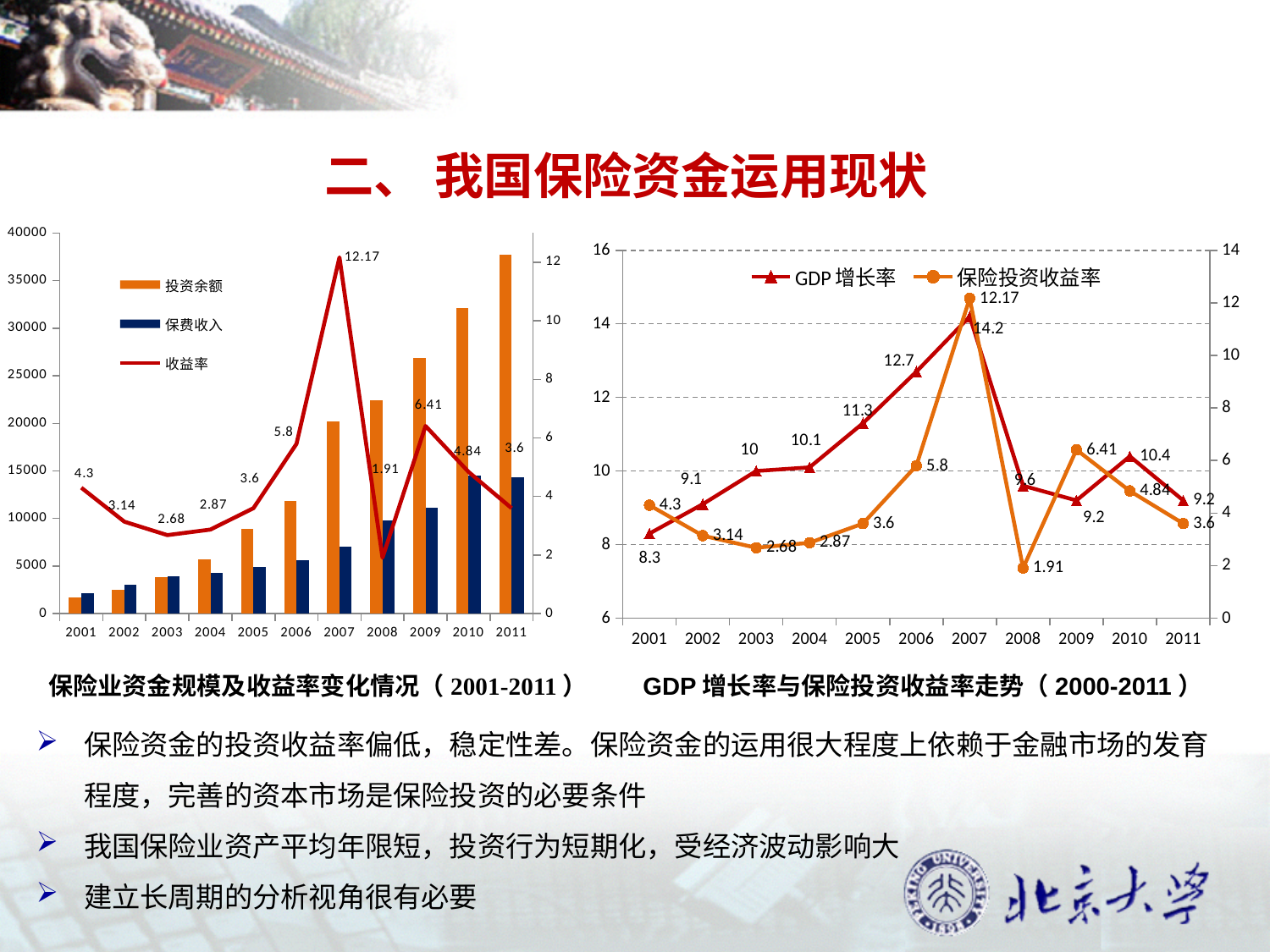
In the right chart (GDP 增长率与保险投资收益率走势), what is the GDP 增长率 value for 2007? 14.2 In the right chart (GDP 增长率与保险投资收益率走势), what is the difference between the GDP 增长率 values for 2007 and 2008? 4.6 In the right chart (GDP 增长率与保险投资收益率走势), which year has the lowest GDP 增长率? 2001 In the right chart (GDP 增长率与保险投资收益率走势), does the GDP 增长率 rise or fall from 2001 to 2007? Rise In the right chart (GDP 增长率与保险投资收益率走势), which is larger in 2010: GDP 增长率 or 保险投资收益率? GDP 增长率 In the right chart (GDP 增长率与保险投资收益率走势), what is the 保险投资收益率 value for 2008? 1.91 How many series does the legend of the right chart (GDP 增长率与保险投资收益率走势) list? 2 In the left chart (保险业资金规模及收益率变化情况), what is the 收益率 value for 2009? 6.41 In the right chart (GDP 增长率与保险投资收益率走势), which year has the highest 保险投资收益率? 2007 What kind of chart is the right chart (GDP 增长率与保险投资收益率走势)? Line chart In the left chart (保险业资金规模及收益率变化情况), is the 投资余额 value for 2011 greater or less than 35000? greater In the left chart (保险业资金规模及收益率变化情况), how many years are shown on the x axis? 11